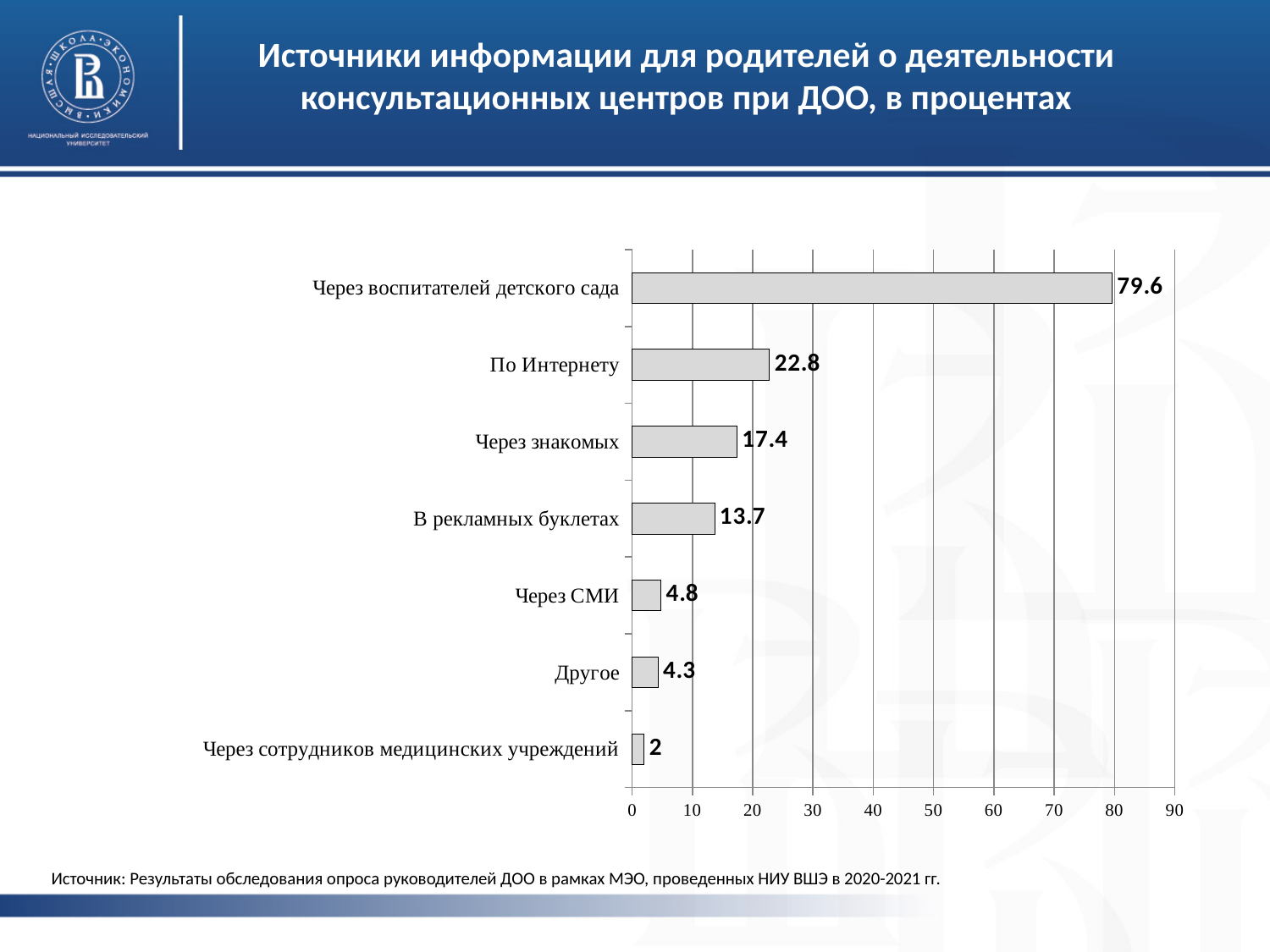
What is the value for "По Интернету"? 22.8 What is the value for "Через сотрудников медицинских учреждений"? 2 What is the difference between the values for "По Интернету" and "Через знакомых"? 5.4 What is the difference between the values for "Через СМИ" and "Другое"? 0.5 How many categories are shown in the chart? 7 Is the value for "Через воспитателей детского сада" greater or less than 70? greater Which category has the highest value? Через воспитателей детского сада Which category has the lowest value? Через сотрудников медицинских учреждений Which is larger, the value for "В рекламных буклетах" or the value for "Через знакомых"? Через знакомых What is the value for "Через СМИ"? 4.8 What kind of chart is shown on the slide? bar chart What is the value for "Через воспитателей детского сада"? 79.6